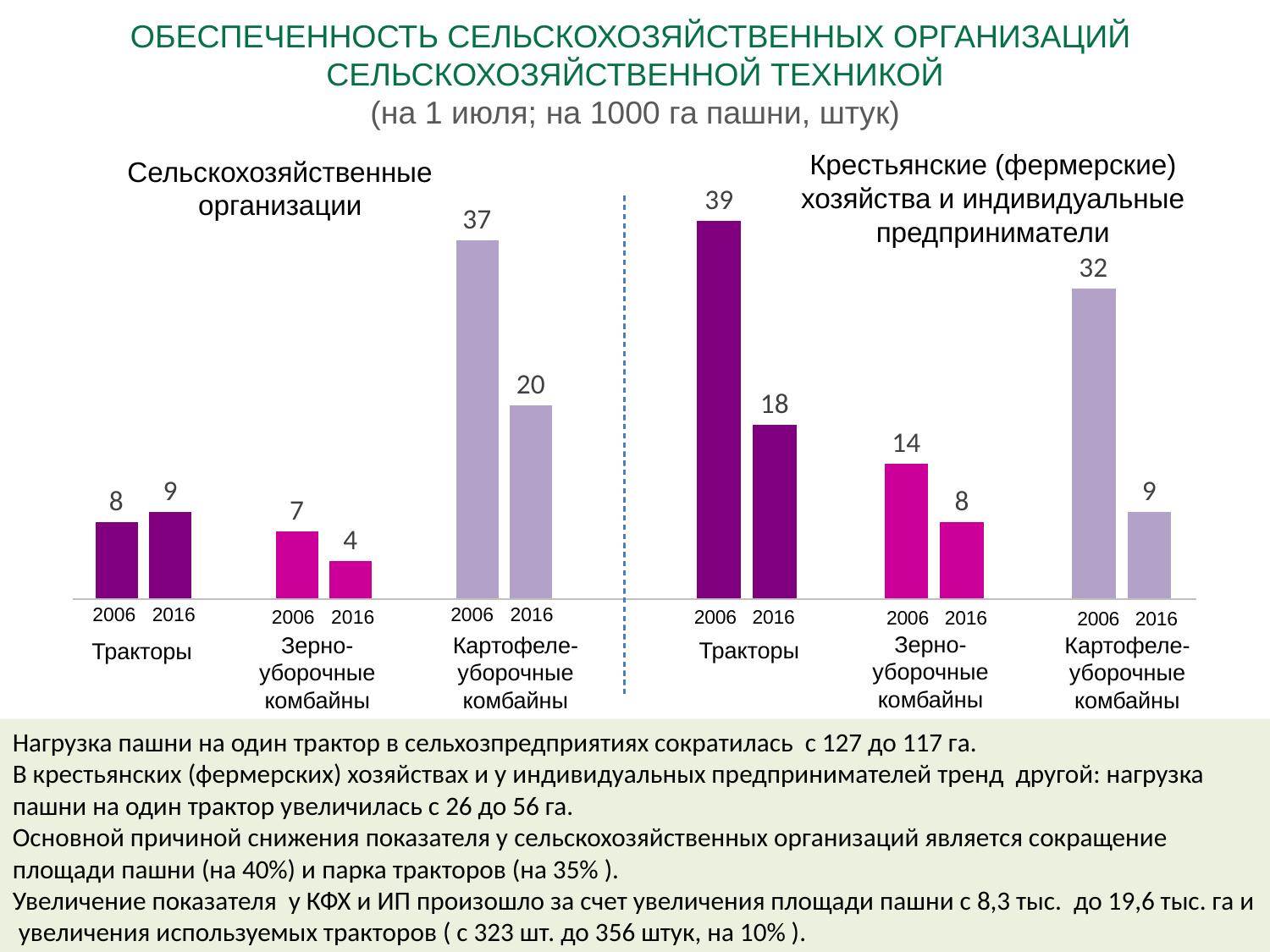
In the left chart (Сельскохозяйственные организации), what is the difference between the 2006 and 2016 values for Картофелеуборочные комбайны? 17 Which is larger: the 2006 value for Картофелеуборочные комбайны in the left chart or in the right chart? Left chart (Сельскохозяйственные организации), 37 In the left chart (Сельскохозяйственные организации), what is the value for Картофелеуборочные комбайны in 2006? 37 In the right chart (Крестьянские (фермерские) хозяйства), by how much did the value for Тракторы fall from 2006 to 2016? 21 In the right chart (Крестьянские (фермерские) хозяйства и индивидуальные предприниматели), what is the value for Тракторы in 2006? 39 In the left chart (Сельскохозяйственные организации), which bar has the highest value? Картофелеуборочные комбайны, 2006 In the left chart (Сельскохозяйственные организации), which bar has the lowest value? Зерноуборочные комбайны, 2016 In the left chart (Сельскохозяйственные организации), what is the value for Тракторы in 2016? 9 What type of chart is used on the slide? Bar chart In the right chart (Крестьянские (фермерские) хозяйства), what is the value for Зерноуборочные комбайны in 2016? 8 In the right chart (Крестьянские (фермерские) хозяйства), did the value for Зерноуборочные комбайны rise or fall from 2006 to 2016? Fall How many equipment categories are shown in each chart? 3